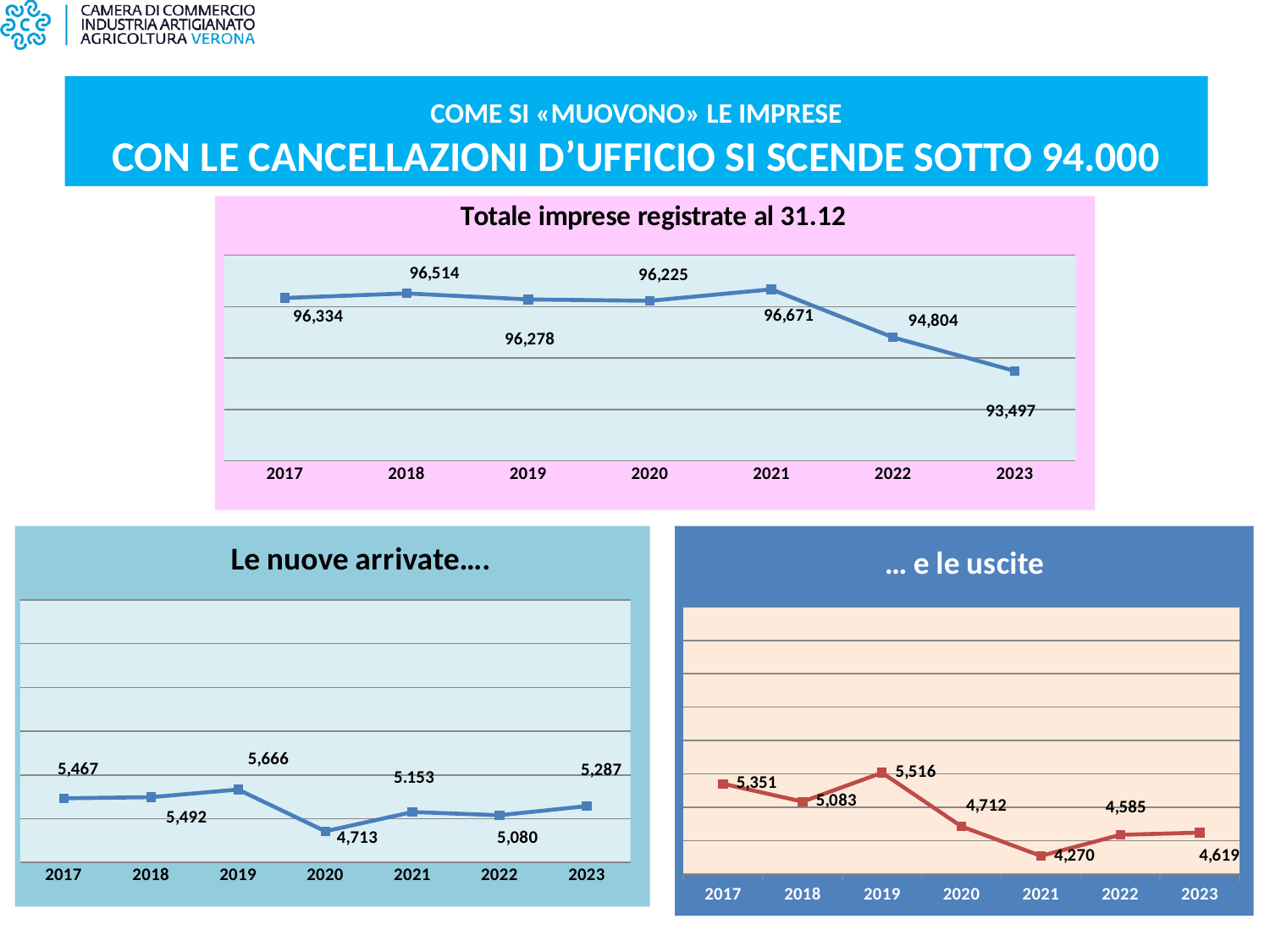
In the chart titled "... e le uscite", what is the value for 2021? 4,270 In the chart titled "Totale imprese registrate al 31.12", which year has the highest value? 2021 In the chart titled "... e le uscite", do the values rise or fall from 2019 to 2021? fall In the chart titled "Le nuove arrivate....", which is larger, the value for 2017 or the value for 2018? 2018 In the chart titled "Totale imprese registrate al 31.12", what is the value for 2023? 93,497 What kind of chart is "Totale imprese registrate al 31.12"? line chart In the chart titled "Totale imprese registrate al 31.12", how many years are plotted? 7 In the chart titled "... e le uscite", which year has the highest value? 2019 In the chart titled "Le nuove arrivate....", which year has the lowest value? 2020 In the chart titled "Le nuove arrivate....", what is the value for 2019? 5,666 In the chart titled "Totale imprese registrate al 31.12", what is the difference between the 2022 value and the 2023 value? 1,307 In the chart titled "... e le uscite", what is the difference between the 2019 value and the 2018 value? 433